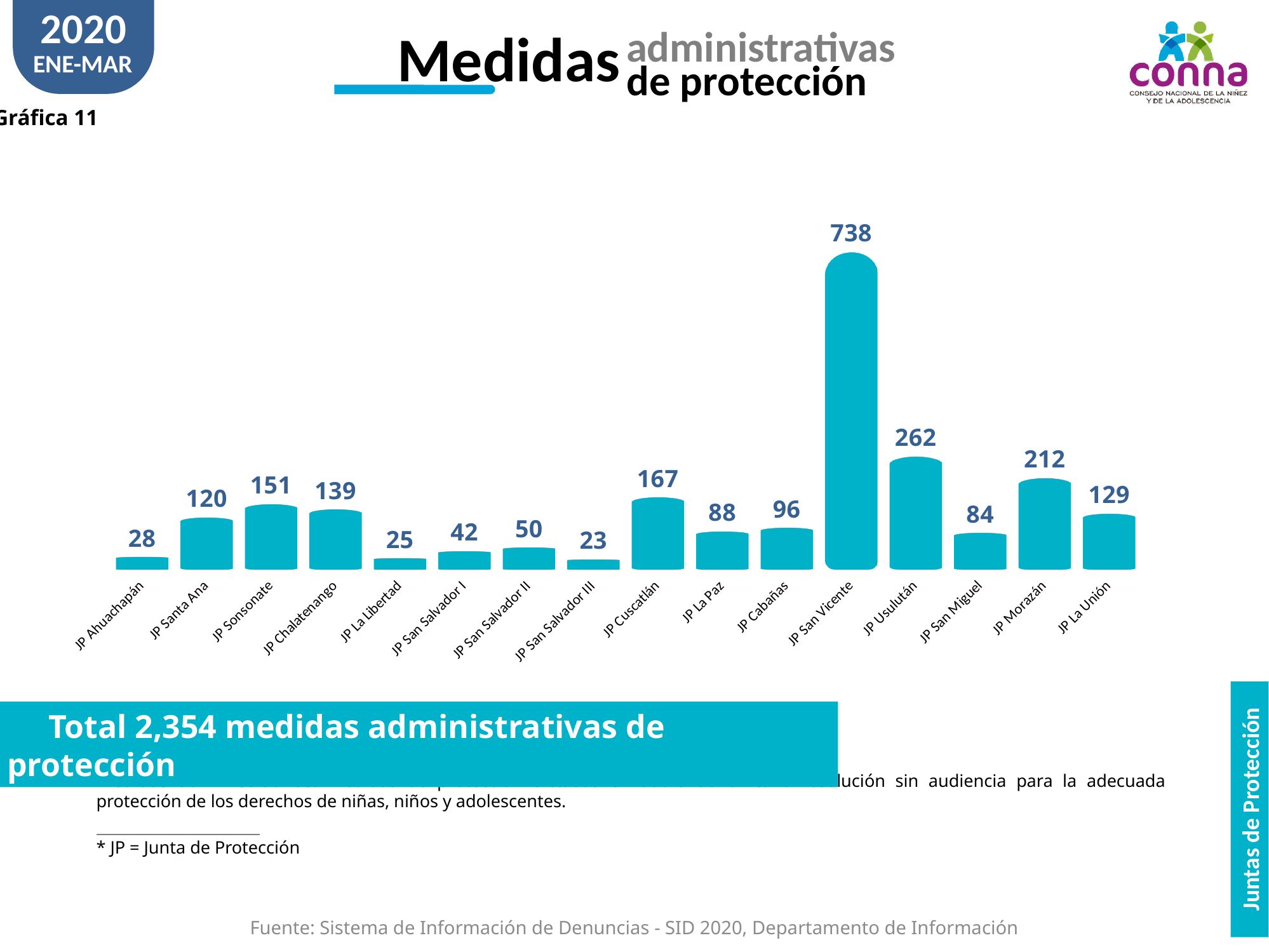
What is the value for JP Morazán? 212 What is the value for JP La Paz? 88 How many categories are shown in the chart? 16 What total of administrative protection measures is stated on the slide? 2,354 What is the difference between the values for JP San Vicente and JP Usulután? 476 Which is larger, the value for JP Sonsonate or the value for JP Chalatenango? JP Sonsonate What is the difference between the values for JP Santa Ana and JP La Unión? 9 What is the value for JP San Vicente? 738 Which category has the lowest value? JP San Salvador III What is the value for JP Cuscatlán? 167 Which category has the highest value? JP San Vicente What kind of chart is shown on the slide? Bar chart